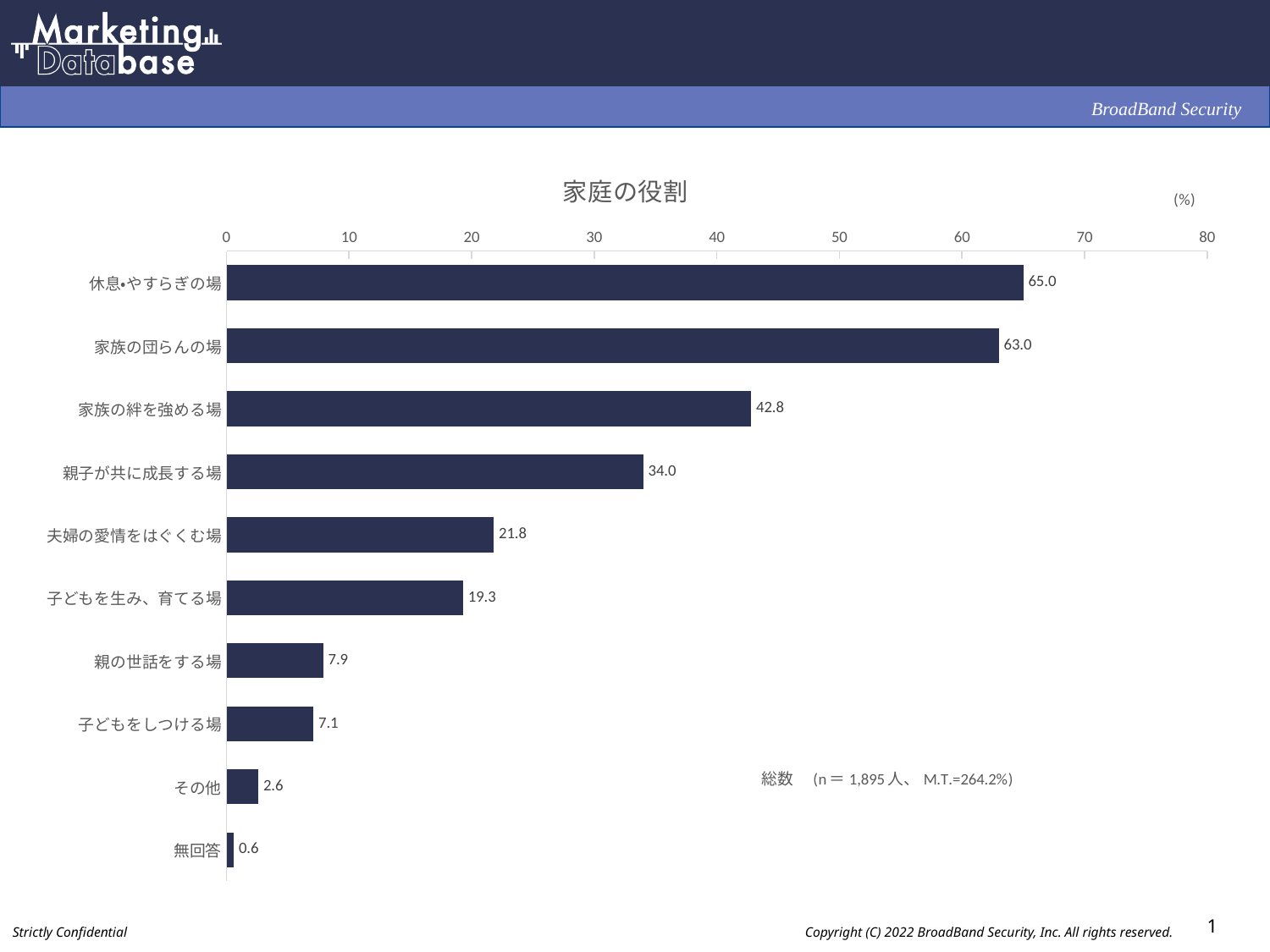
Is the value for 家族の絆を強める場 greater or less than 40? greater Which category has the highest value? 休息•やすらぎの場 What is the value for 家族の絆を強める場? 42.8 What is the difference between 休息•やすらぎの場 and 家族の団らんの場? 2.0 What is the value for 夫婦の愛情をはぐくむ場? 21.8 Which category has the lowest value? 無回答 How many categories are shown in the chart? 10 Which is larger, 親の世話をする場 or 子どもをしつける場? 親の世話をする場 What is the value for 親の世話をする場? 7.9 What is the difference between 親子が共に成長する場 and 子どもを生み、育てる場? 14.7 What kind of chart is shown on the slide? bar chart What is the title of the chart? 家庭の役割